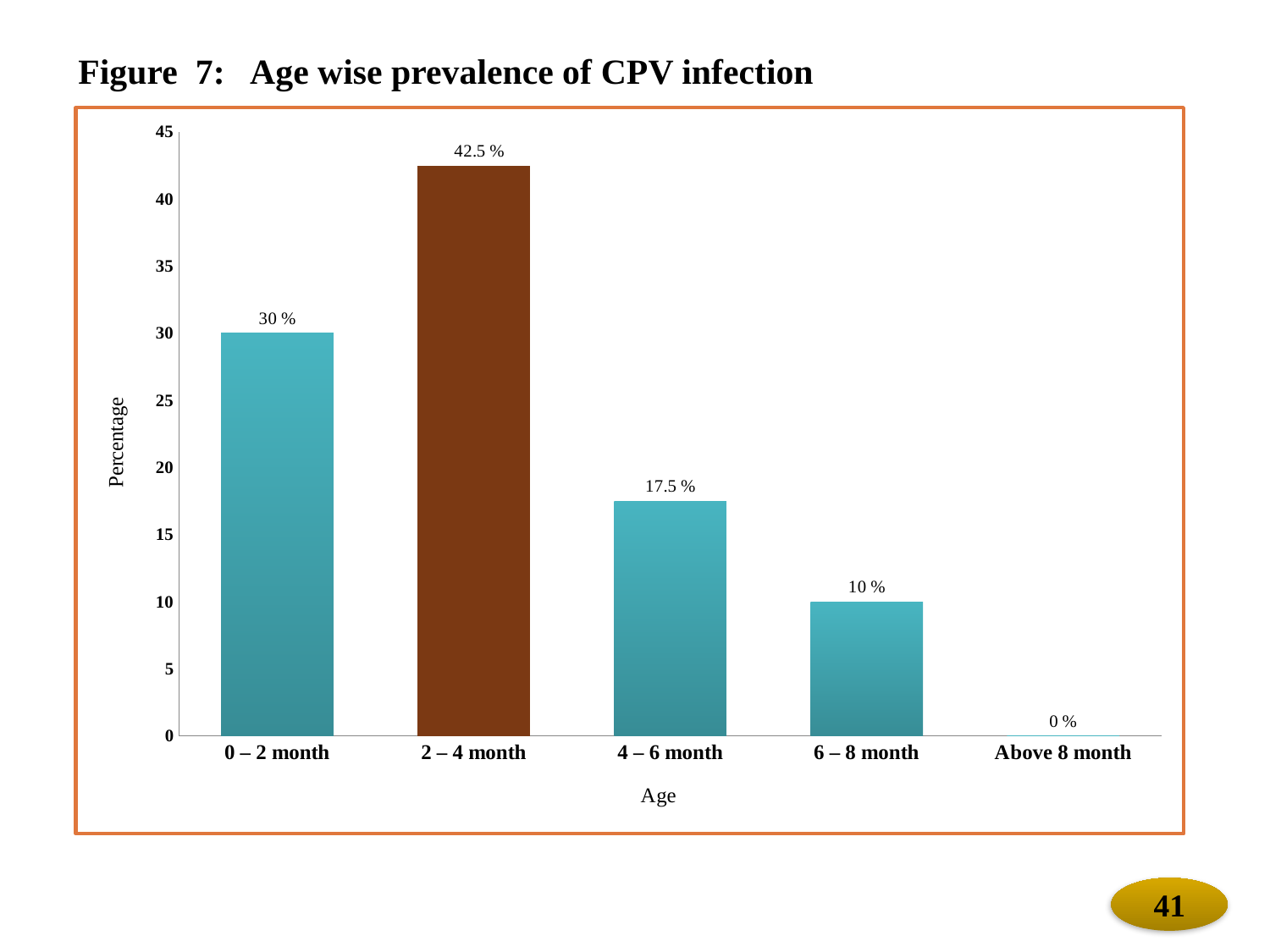
Is the value for the 4 – 6 month age group greater or less than 20? less What is the prevalence of CPV infection for the 6 – 8 month age group? 10 % What is the label of the y axis of the chart? Percentage Which age group has the lowest prevalence of CPV infection? Above 8 month How many age groups are shown on the chart? 5 What is the difference in prevalence between the 2 – 4 month and 0 – 2 month age groups? 12.5 % What is the prevalence of CPV infection for the 2 – 4 month age group? 42.5 % What is the prevalence of CPV infection for the 0 – 2 month age group? 30 % Which age group has a higher prevalence, 4 – 6 month or 6 – 8 month? 4 – 6 month What kind of chart is shown on the slide? Bar chart What is the difference in prevalence between the 4 – 6 month and 6 – 8 month age groups? 7.5 % Which age group has the highest prevalence of CPV infection? 2 – 4 month